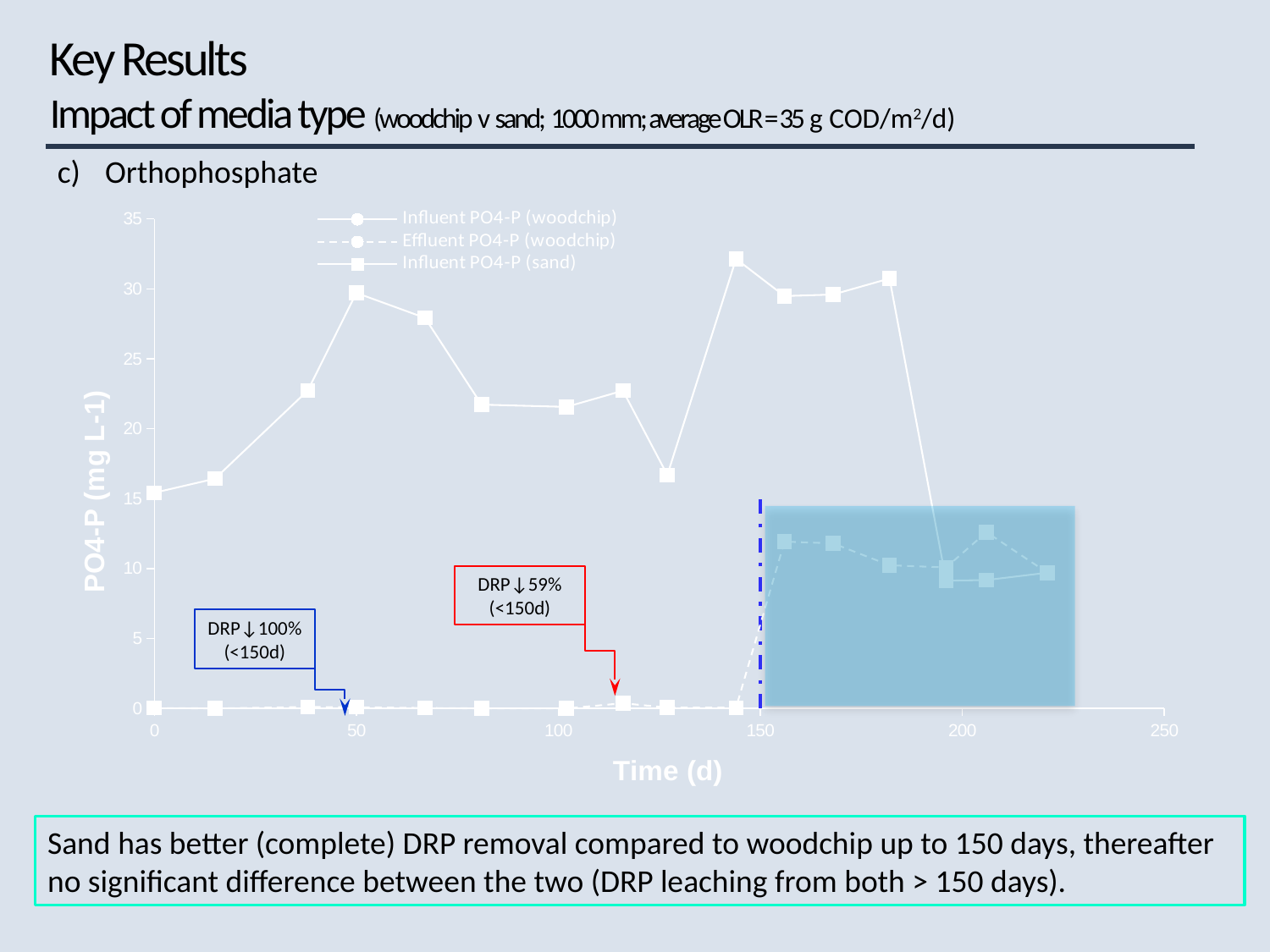
What is the title of the y-axis of the chart? PO4-P (mg L-1) Is the influent PO4-P value at day 0 greater or less than 20 mg L-1? less Is the effluent PO4-P value at around day 155 greater or less than 10 mg L-1? greater Is the effluent PO4-P value at day 100 greater or less than 5 mg L-1? less What is the title of the x-axis of the chart? Time (d) How many series does the chart legend list? 3 What kind of chart is shown on the slide? Line chart Which is larger: the influent PO4-P at around day 145 or the influent PO4-P at around day 125? around day 145 What is the highest value shown on the y-axis of the chart? 35 Does the influent PO4-P rise or fall between day 0 and day 50? rise